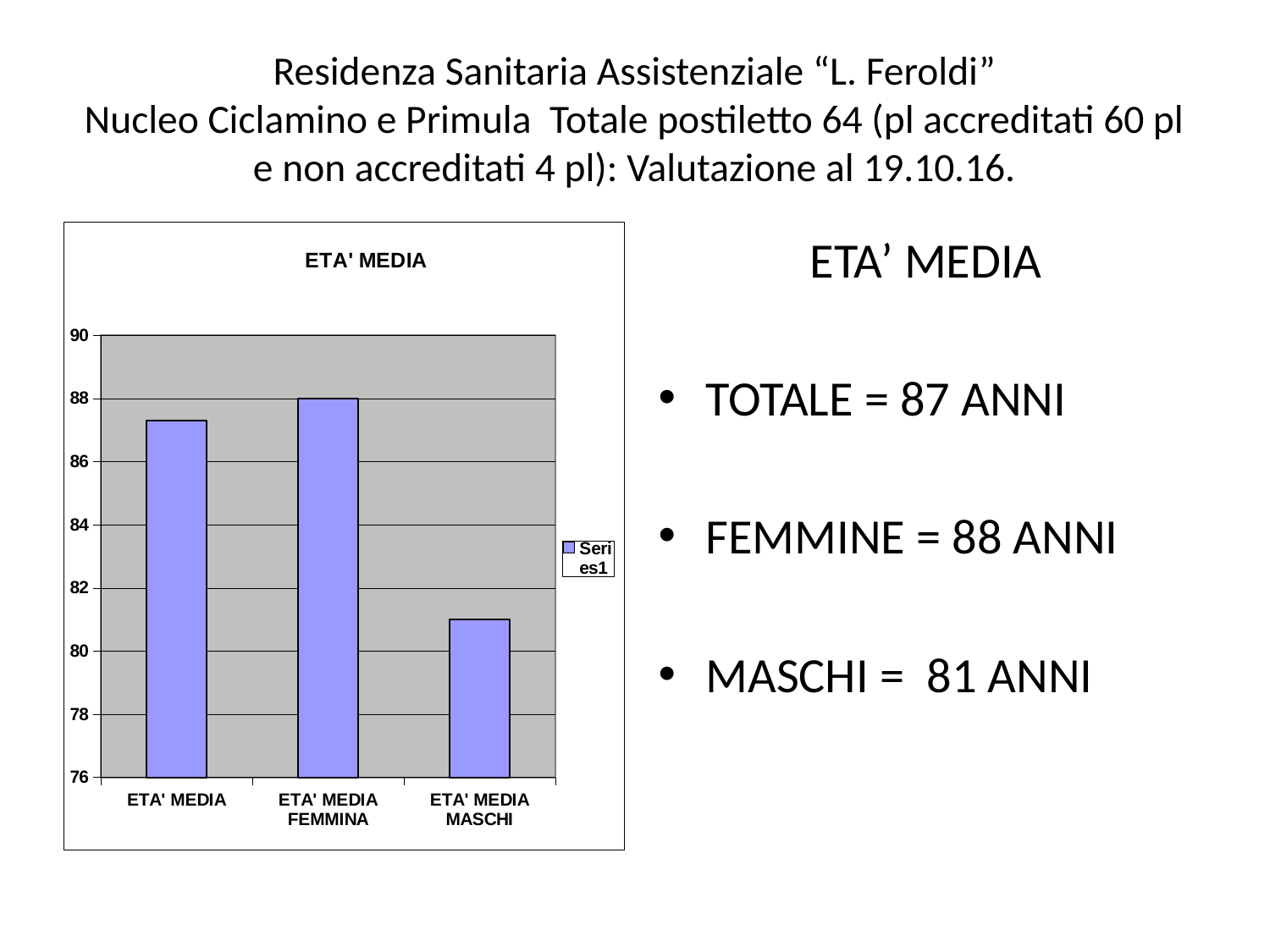
What kind of chart is shown on the slide? bar chart How many series does the chart legend list? 1 Is the value for ETA' MEDIA (the first bar) greater or less than 86? greater What is the title of the chart? ETA' MEDIA Which is larger, the ETA' MEDIA bar or the ETA' MEDIA MASCHI bar? ETA' MEDIA What is the value of the ETA' MEDIA FEMMINA bar? 88 Is the value for ETA' MEDIA MASCHI greater or less than 80? greater Is the value for ETA' MEDIA MASCHI greater or less than 82? less Which category has the highest bar in the chart? ETA' MEDIA FEMMINA Which category has the lowest bar in the chart? ETA' MEDIA MASCHI How many bars (categories) does the chart show? 3 What is the name of the series shown in the chart legend? Series1